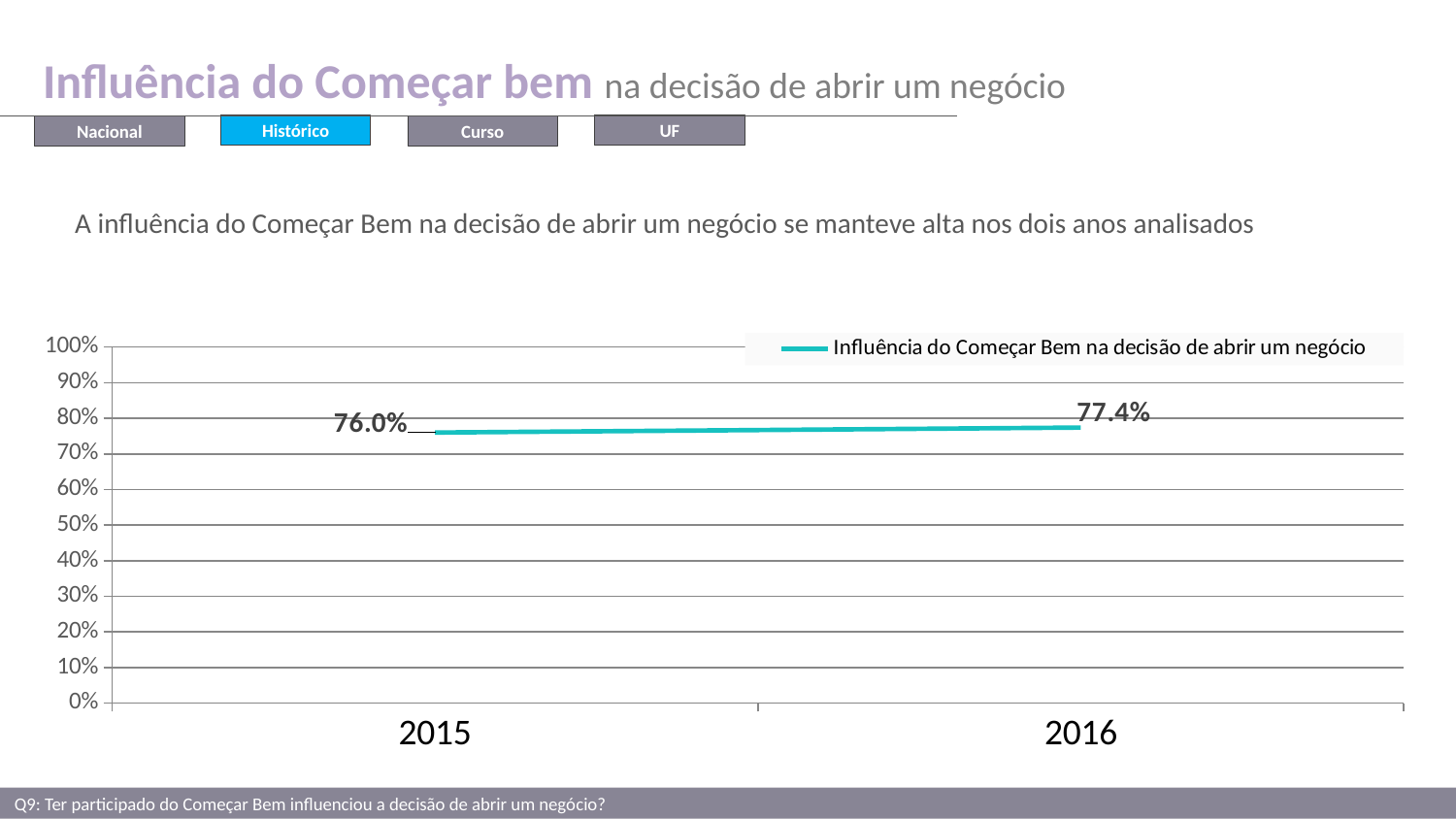
What is the legend entry for the plotted series? Influência do Começar Bem na decisão de abrir um negócio Is the value for 2016 greater or less than 80%? less Is the value for 2015 greater or less than 70%? greater Does the value rise or fall from 2015 to 2016? rise Which year has the lower value? 2015 What kind of chart is shown? line chart What is the value for 2015? 76.0% How many series does the legend list? 1 How many years are plotted on the x axis? 2 What is the value for 2016? 77.4% What is the difference between the 2016 and 2015 values? 1.4% Which year has the higher value? 2016